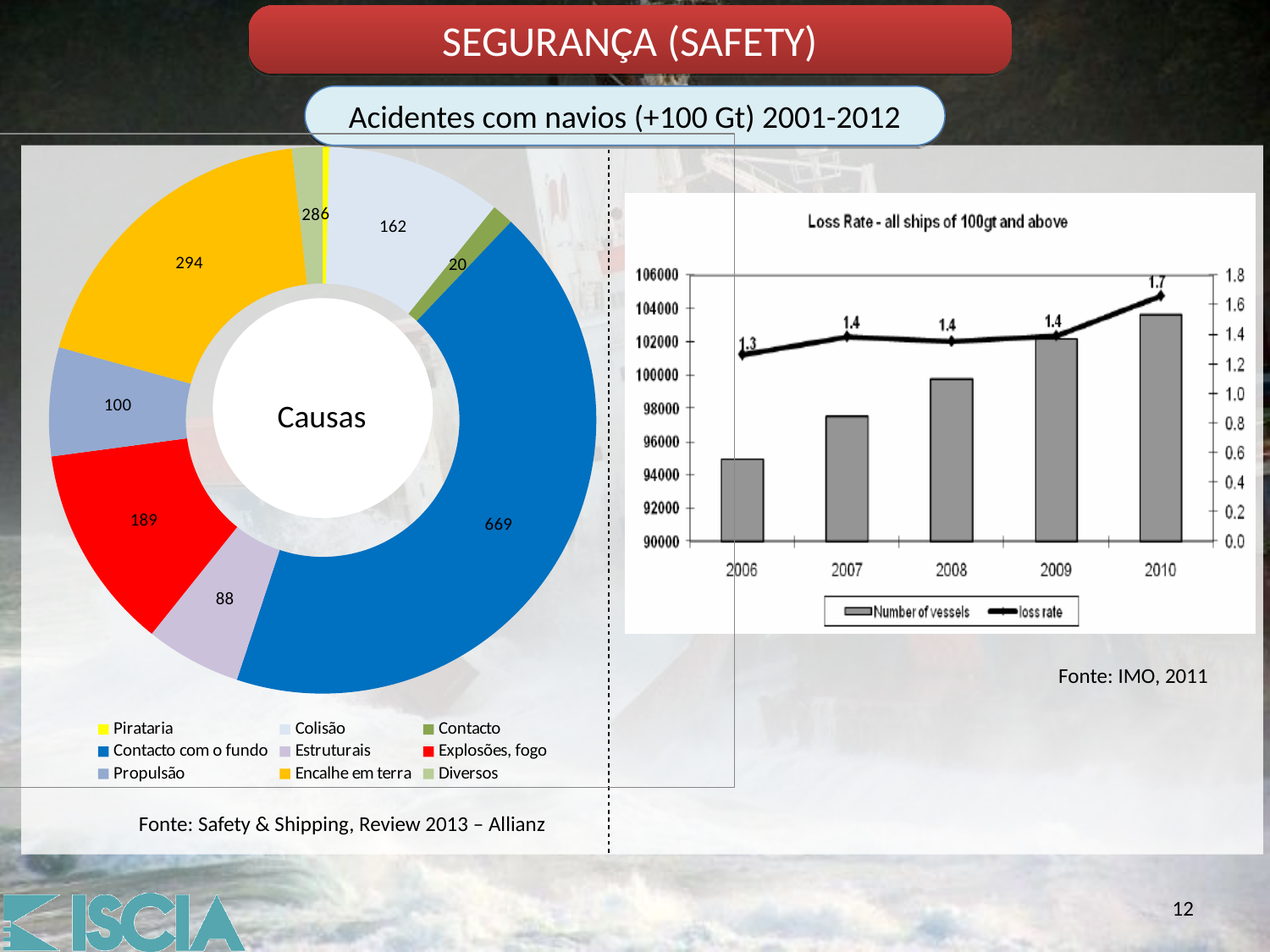
In the 'Loss Rate - all ships of 100gt and above' chart, what is the loss rate for 2006? 1.3 In the 'Loss Rate - all ships of 100gt and above' chart, does the number of vessels rise or fall from 2006 to 2010? rise In the 'Causas' doughnut chart, which is larger: Colisão or Propulsão? Colisão In the 'Causas' doughnut chart, which cause has the highest value? Contacto com o fundo In the 'Causas' doughnut chart, what is the value for Encalhe em terra? 294 In the 'Causas' doughnut chart, what is the value for Contacto com o fundo? 669 In the 'Loss Rate - all ships of 100gt and above' chart, is the number of vessels for 2006 greater or less than 96000? less In the 'Causas' doughnut chart, what is the value for Explosões, fogo? 189 How many series does the legend of the 'Loss Rate - all ships of 100gt and above' chart list? 2 In the 'Causas' doughnut chart, what is the difference between Contacto com o fundo and Encalhe em terra? 375 In the 'Loss Rate - all ships of 100gt and above' chart, what is the loss rate for 2010? 1.7 How many entries does the legend of the 'Causas' doughnut chart list? 9